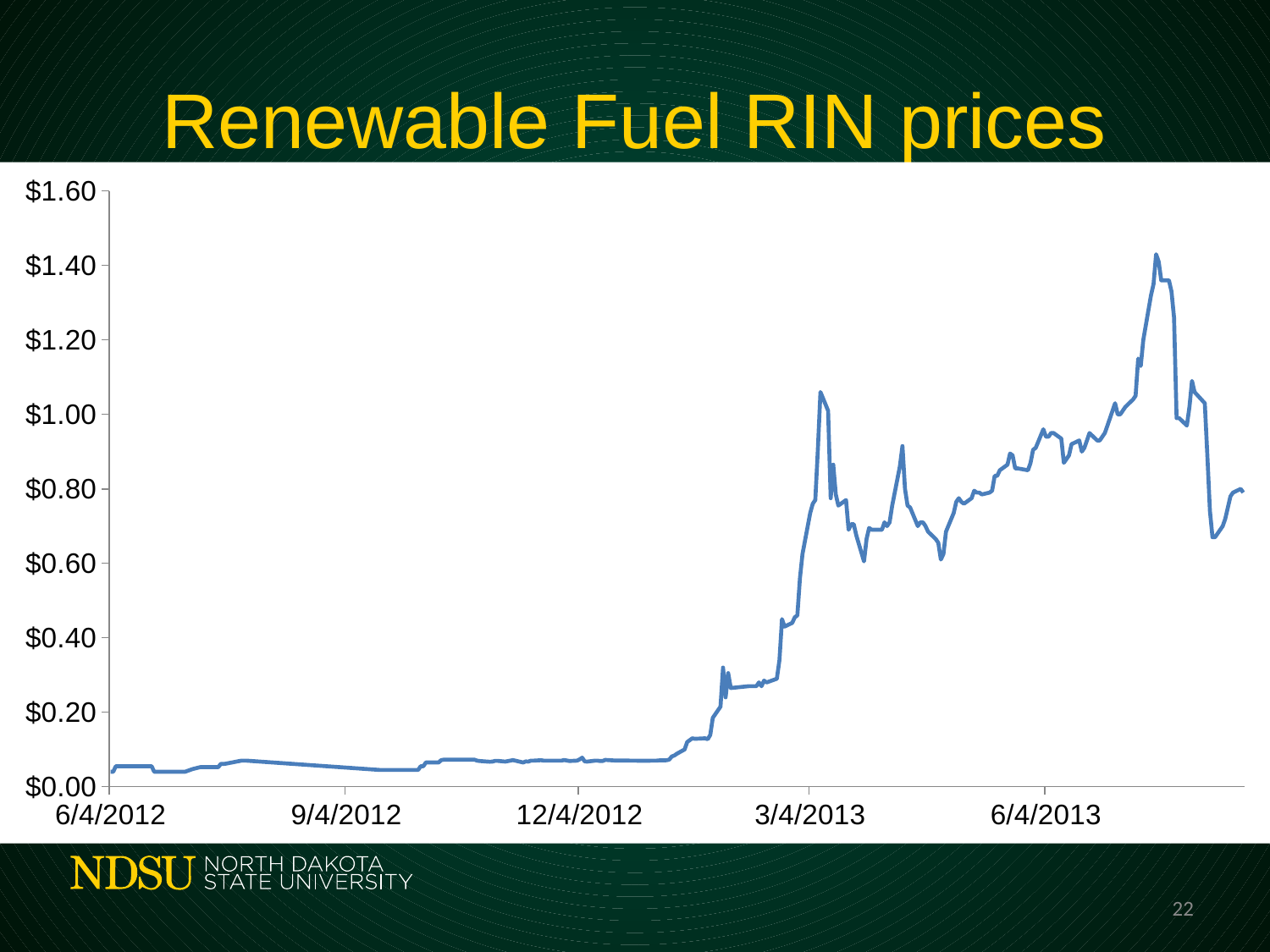
Overall, do the RIN prices rise or fall from 6/4/2012 to 6/4/2013? rise Is the value at 3/4/2013 greater or less than $0.60? greater Which is larger, the value at 3/4/2013 or the value at 9/4/2012? 3/4/2013 Is the value at 12/4/2012 greater or less than $0.20? less Is the value at 6/4/2013 greater or less than $0.80? greater What kind of chart is shown on the slide? Line chart How many date labels are shown on the x axis? 5 What is the title of the chart? Renewable Fuel RIN prices What is the highest value labelled on the y axis? $1.60